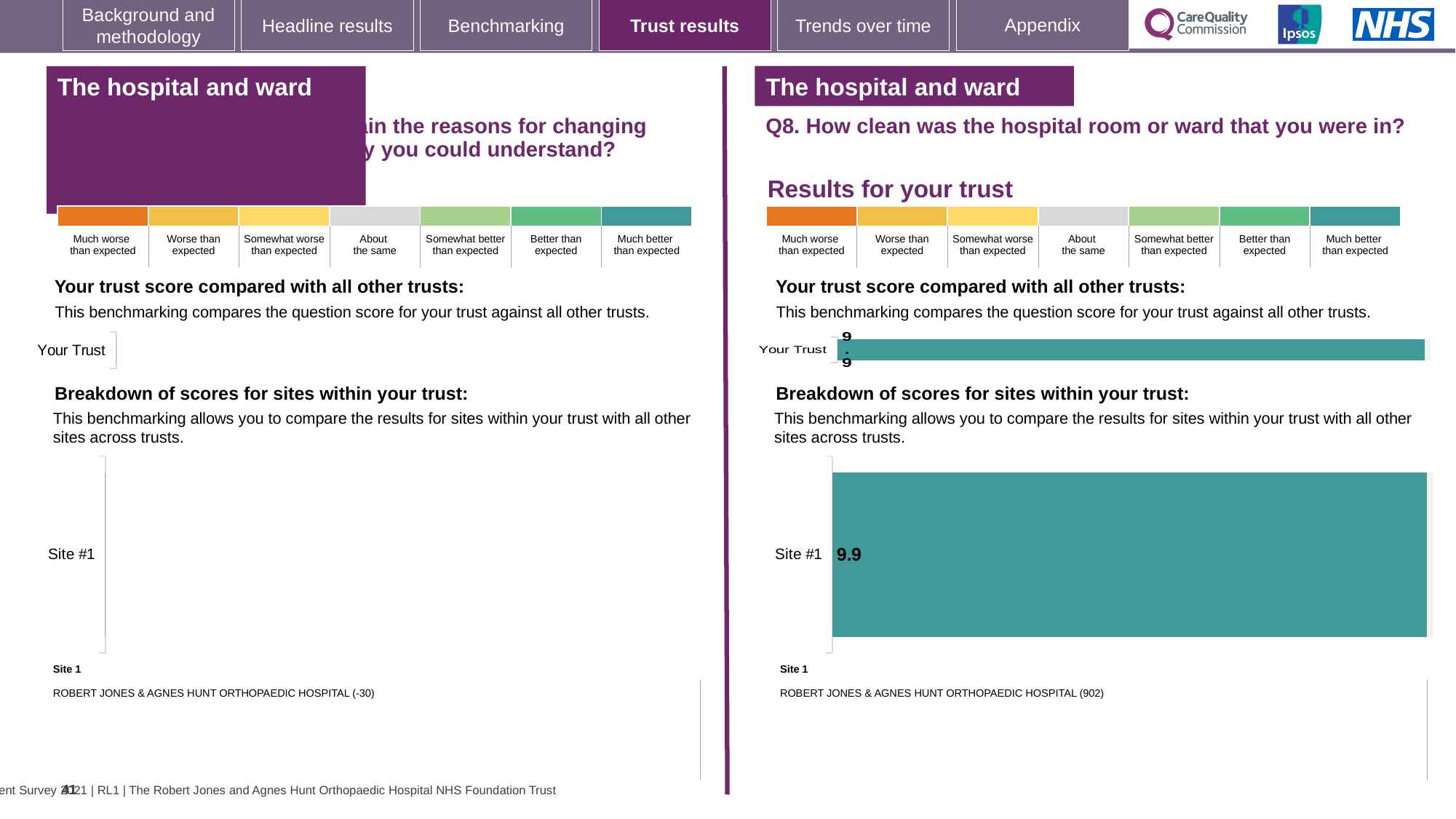
On the right-hand chart 'Breakdown of scores for sites within your trust' for Q8, what is the score for Site #1? 9.9 On the right-hand side of the slide, which benchmark band does the colour of the Site #1 bar correspond to? Much better than expected What kind of chart is used to show the Site #1 score on the right-hand side of the slide? Bar chart On the right-hand chart 'Your trust score compared with all other trusts' for Q8, what is the score for Your Trust? 9.9 On the right-hand 'Your trust score compared with all other trusts' chart, how many bars are plotted? 1 On the right-hand 'Breakdown of scores for sites within your trust' chart, how many sites are plotted? 1 How many benchmark bands are shown in the colour scale above the right-hand charts? 7 On the right-hand side of the slide, is the Site #1 score the same as the Your Trust score? Yes